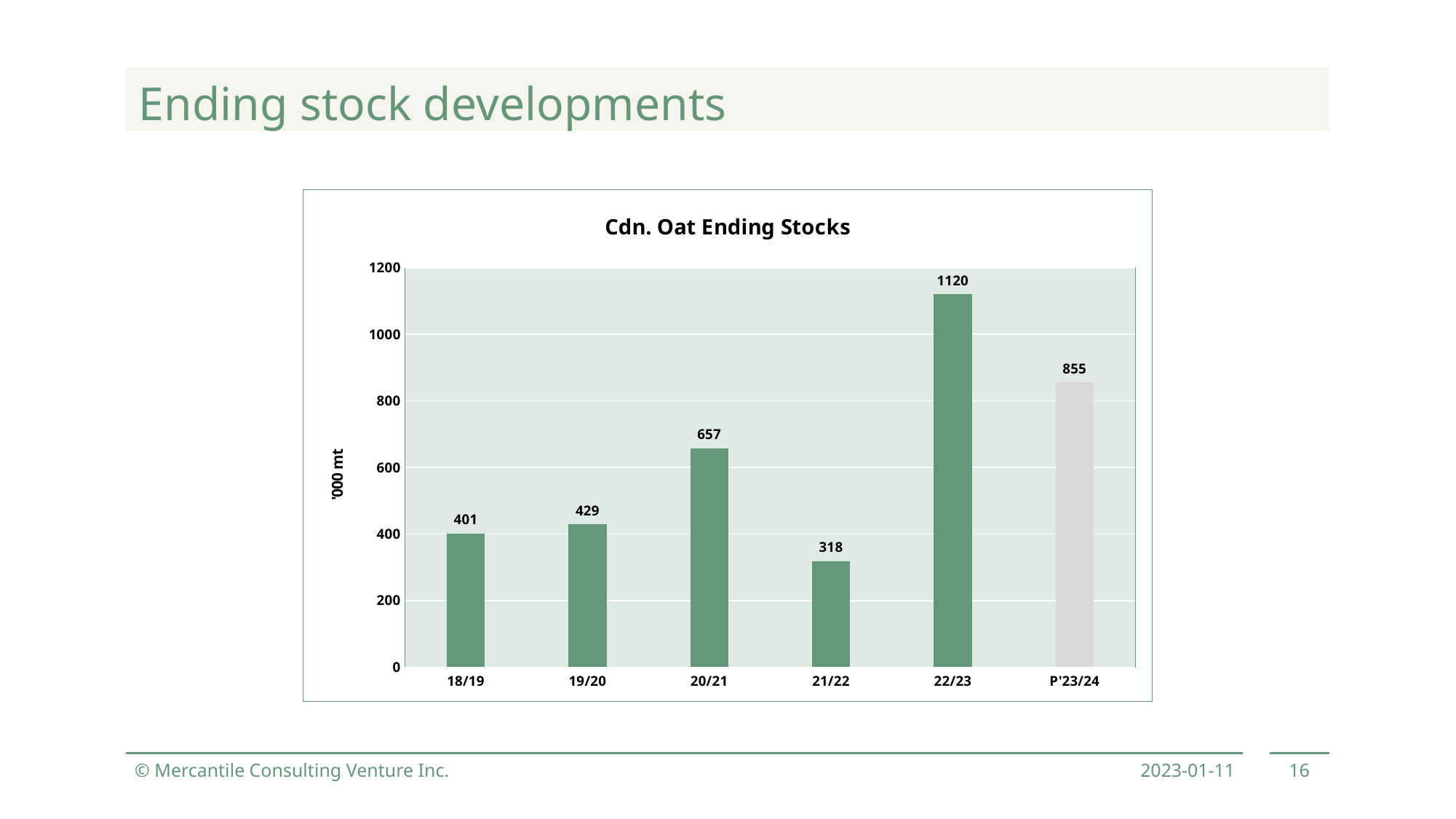
What is the difference between the values for 20/21 and 19/20? 228 How many years are shown on the x axis of the chart? 6 Which is larger, the value for 19/20 or the value for 18/19? 19/20 Which year has the highest ending stocks in the chart? 22/23 What is the value for 21/22 in the Cdn. Oat Ending Stocks chart? 318 What is the value for 18/19 in the Cdn. Oat Ending Stocks chart? 401 What is the label on the vertical axis of the chart? '000 mt What is the difference between the values for 22/23 and P'23/24? 265 Which year has the lowest ending stocks in the chart? 21/22 Is the value for 20/21 greater or less than 600? greater What kind of chart is shown on the slide? bar chart What is the value for P'23/24 in the Cdn. Oat Ending Stocks chart? 855